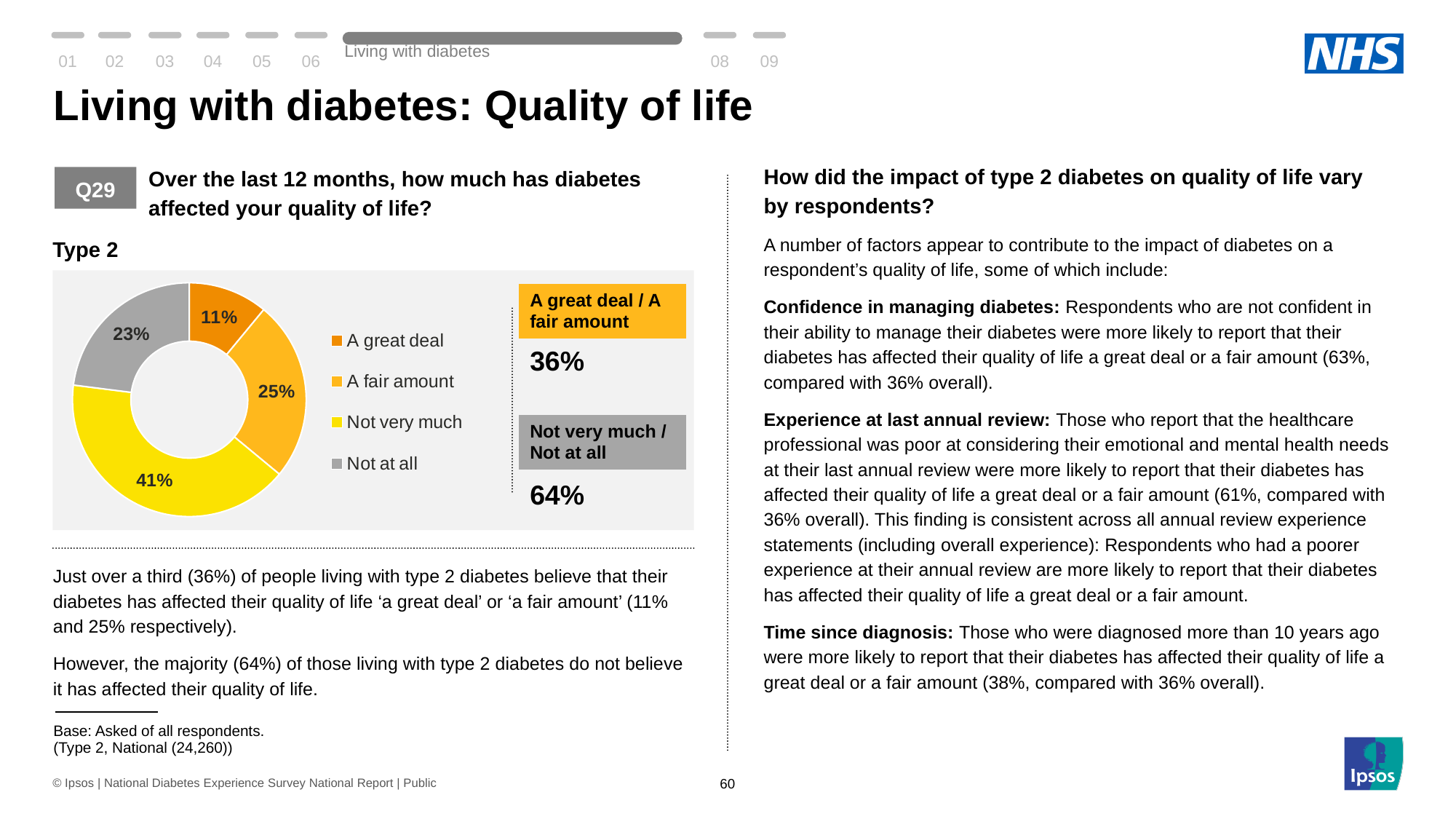
What percentage of type 2 respondents answered 'Not very much'? 41% What percentage of type 2 respondents answered 'Not at all'? 23% What percentage of type 2 respondents said diabetes affected their quality of life 'A fair amount'? 25% What percentage of type 2 respondents said diabetes affected their quality of life 'A great deal'? 11% Which is larger, the share for 'A fair amount' or the share for 'Not at all'? A fair amount What colour represents 'Not very much' in the chart? Yellow What is the difference in percentage points between 'Not very much' and 'Not at all'? 18 What is the combined share for 'A great deal' and 'A fair amount'? 36% Which response category has the largest share of the pie? Not very much Which response category has the smallest share of the pie? A great deal What type of chart is used to show the Q29 results? Pie chart (doughnut) How many response categories are shown in the pie chart? 4